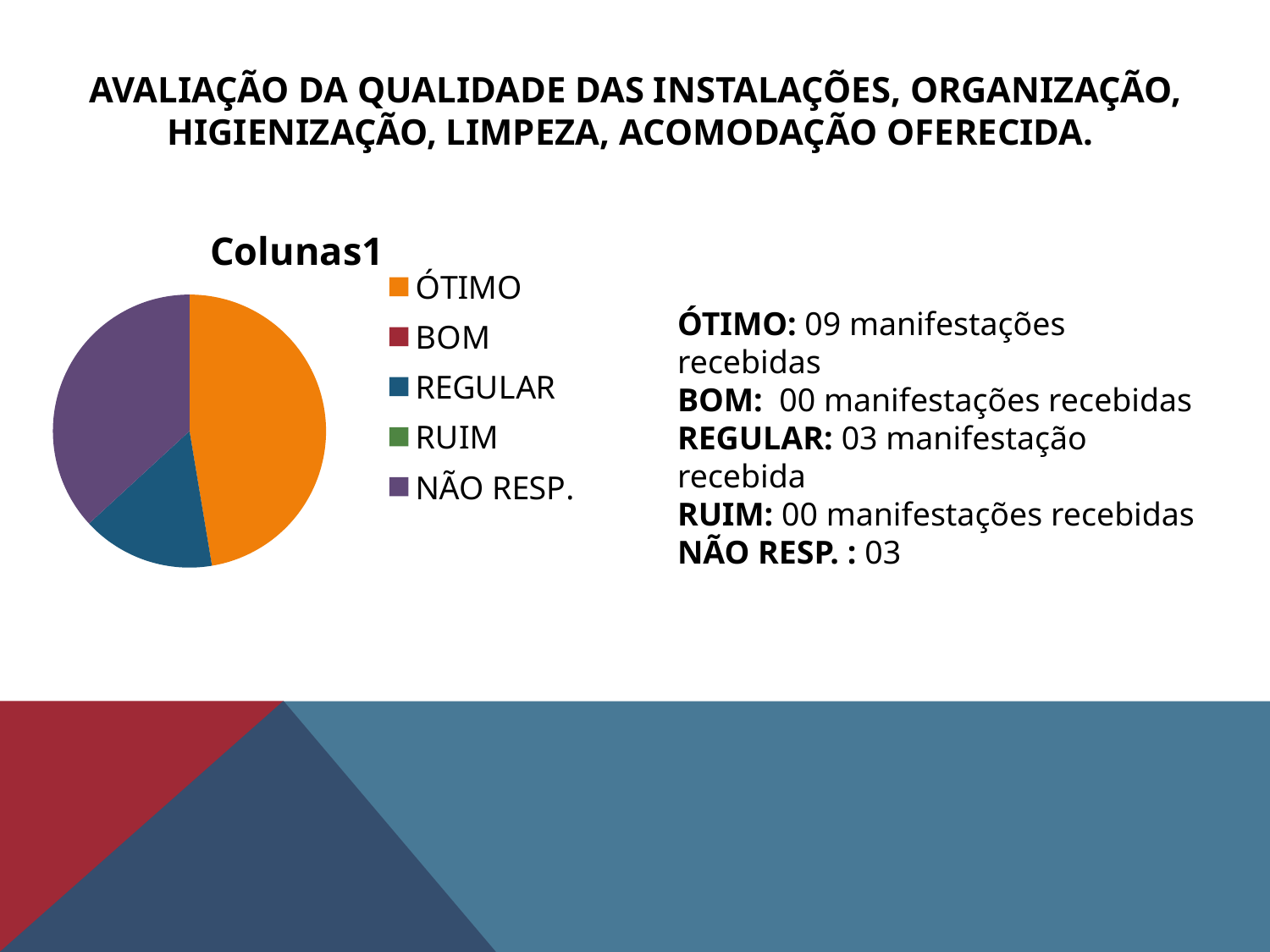
How many manifestações were received for BOM? 00 What is the difference between the ÓTIMO and REGULAR values? 6 What colour is the ÓTIMO slice in the pie chart? orange What kind of chart is shown on the slide? pie chart What is the title of the chart? Colunas1 How many manifestações were received for ÓTIMO? 09 Which is larger, ÓTIMO or REGULAR? ÓTIMO Which category has the largest slice of the pie? ÓTIMO How many manifestações were received for REGULAR? 03 How many categories does the chart's legend list? 5